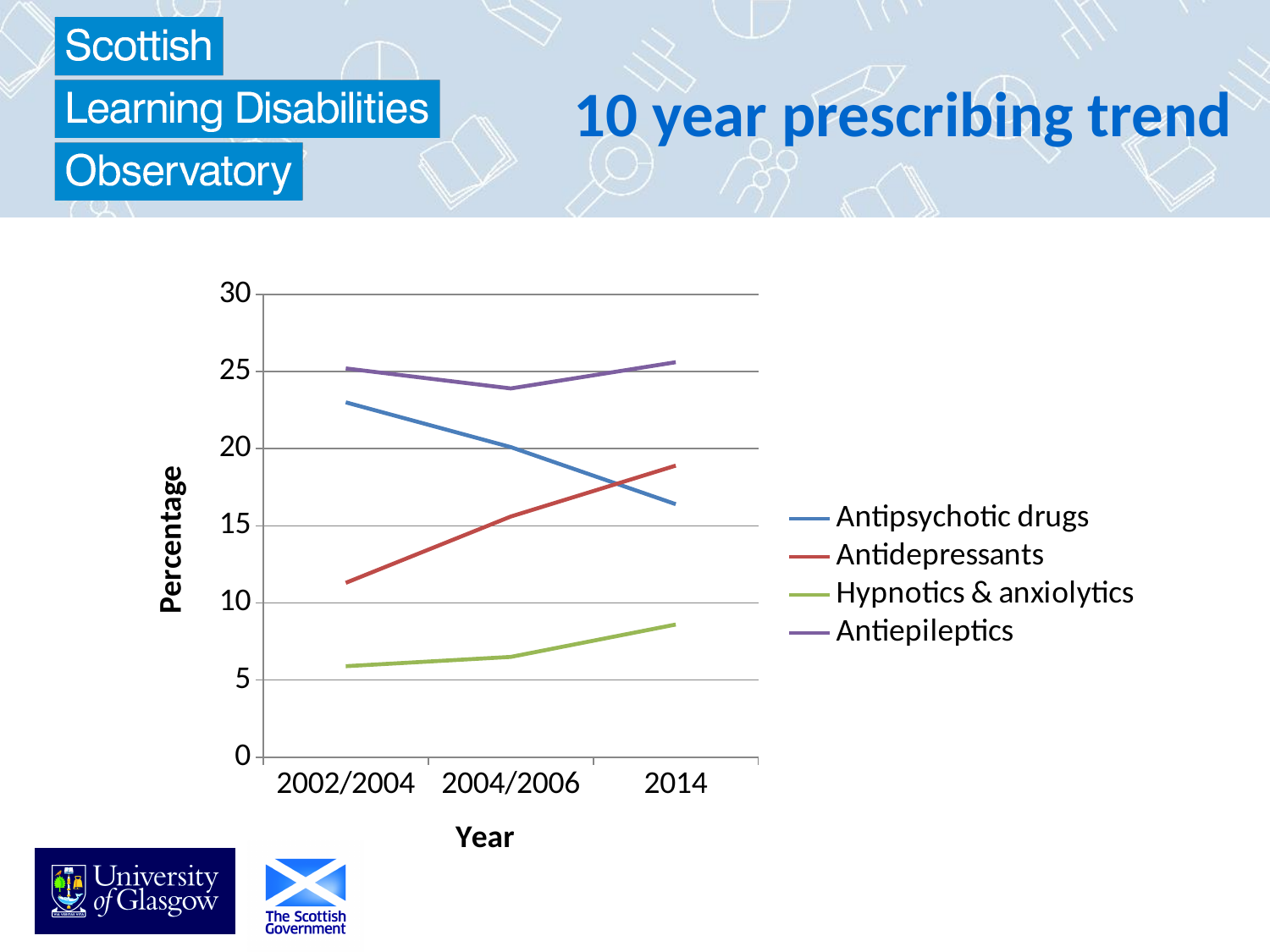
Does the Antipsychotic drugs line rise or fall from 2002/2004 to 2014? fall How many year categories are shown on the x axis? 3 Is the value for Antidepressants in 2002/2004 greater or less than 15? less In 2014, which is higher: Antidepressants or Antipsychotic drugs? Antidepressants How many series does the legend list? 4 What is the title of the vertical axis? Percentage What kind of chart is shown on the slide? line chart Which series has the highest value in 2014? Antiepileptics Does the Antidepressants line rise or fall from 2002/2004 to 2014? rise Is the value for Antipsychotic drugs in 2002/2004 greater or less than 20? greater Which series has the lowest value in 2002/2004? Hypnotics & anxiolytics Does the Hypnotics & anxiolytics line rise or fall from 2002/2004 to 2014? rise